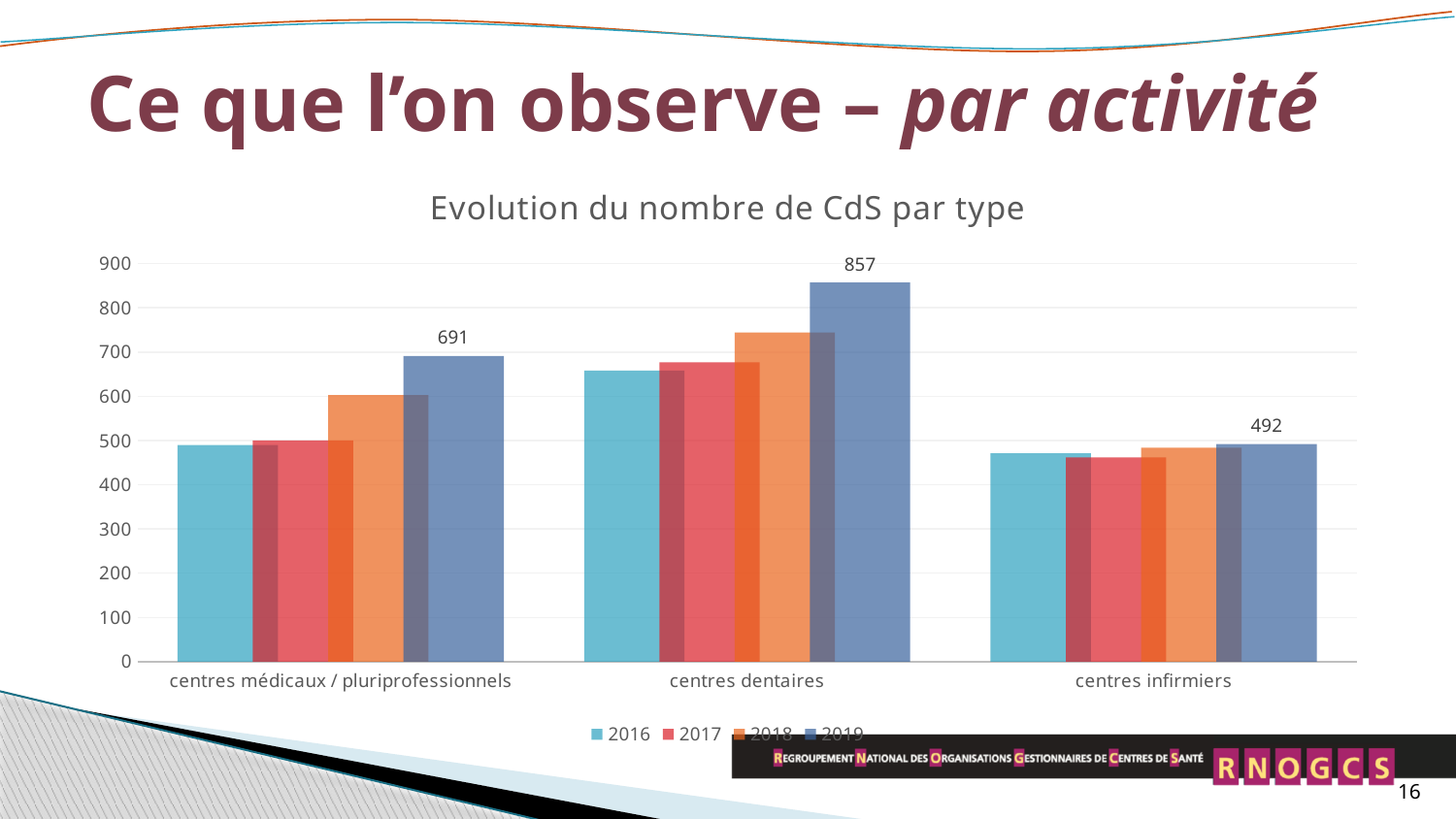
What is the value for centres infirmiers in 2019? 492 How many series does the legend list? 4 Which category has the lowest value in 2019? centres infirmiers What is the value for centres dentaires in 2019? 857 Is the value for centres infirmiers in 2017 greater or less than 500? less What is the difference between the 2019 values for centres dentaires and centres médicaux / pluriprofessionnels? 166 Is the value for centres dentaires in 2016 greater or less than 600? greater Which is larger in 2019: centres médicaux / pluriprofessionnels or centres infirmiers? centres médicaux / pluriprofessionnels Which category has the highest value in 2019? centres dentaires How many categories are shown on the x axis? 3 What kind of chart is shown on the slide? bar chart What is the value for centres médicaux / pluriprofessionnels in 2019? 691